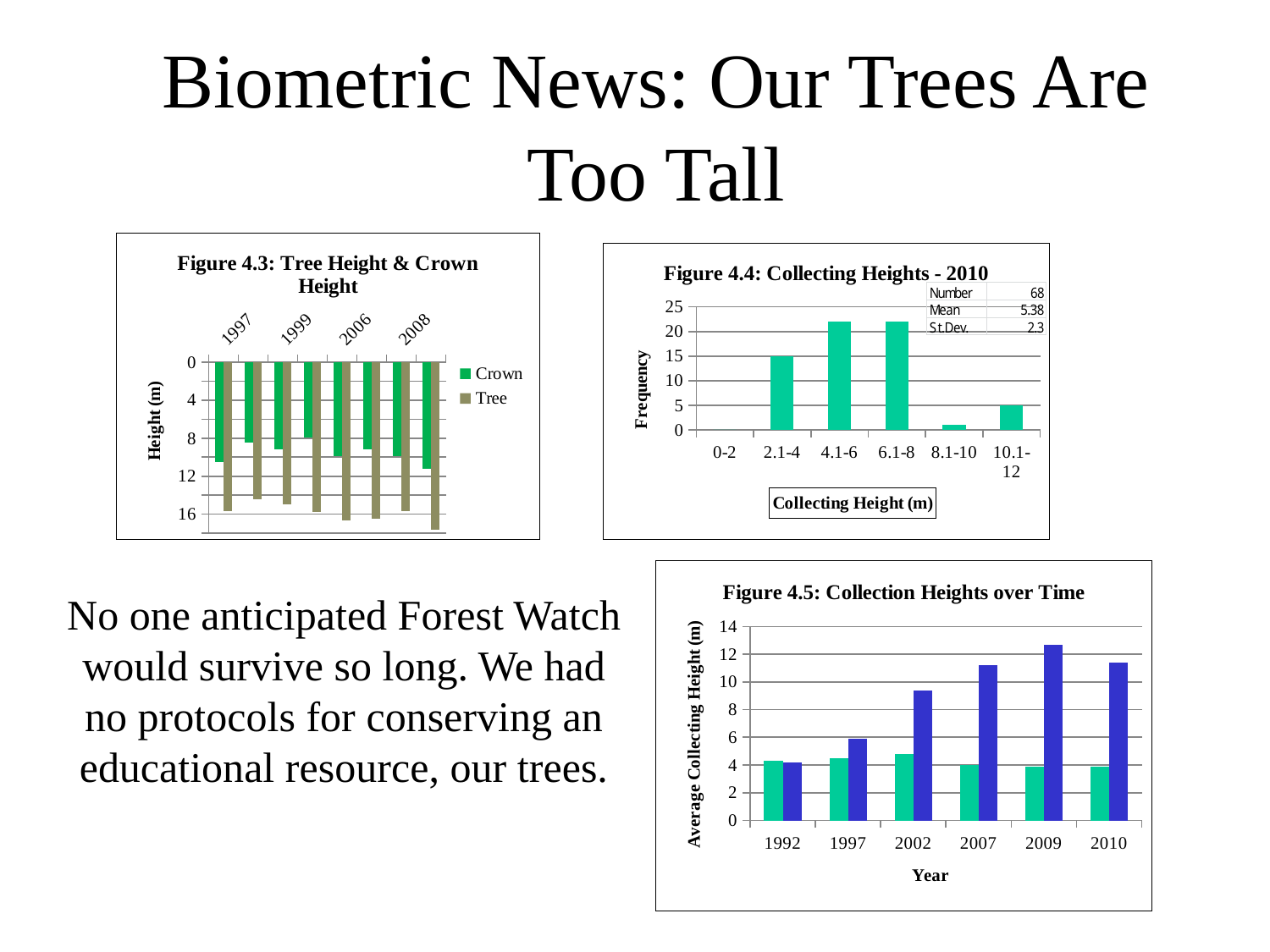
In Figure 4.4: Collecting Heights - 2010, how many collecting height categories are on the x axis? 6 In Figure 4.3: Tree Height & Crown Height, how many series does the legend list? 2 In Figure 4.4: Collecting Heights - 2010, what is the frequency for the 10.1-12 category? 5 In Figure 4.4: Collecting Heights - 2010, what kind of chart is shown? bar chart In Figure 4.3: Tree Height & Crown Height, what are the two legend entries? Crown and Tree In Figure 4.4: Collecting Heights - 2010, is the frequency for the 4.1-6 category greater or less than 20? greater In Figure 4.4: Collecting Heights - 2010, what is the Number shown in the statistics table? 68 In Figure 4.5: Collection Heights over Time, is the blue bar for 2009 greater or less than 12? greater In Figure 4.4: Collecting Heights - 2010, what is the frequency for the 2.1-4 category? 15 In Figure 4.5: Collection Heights over Time, in which year is the blue bar the tallest? 2009 In Figure 4.5: Collection Heights over Time, how many years are shown on the x axis? 6 In Figure 4.4: Collecting Heights - 2010, which has the higher frequency, 2.1-4 or 10.1-12? 2.1-4